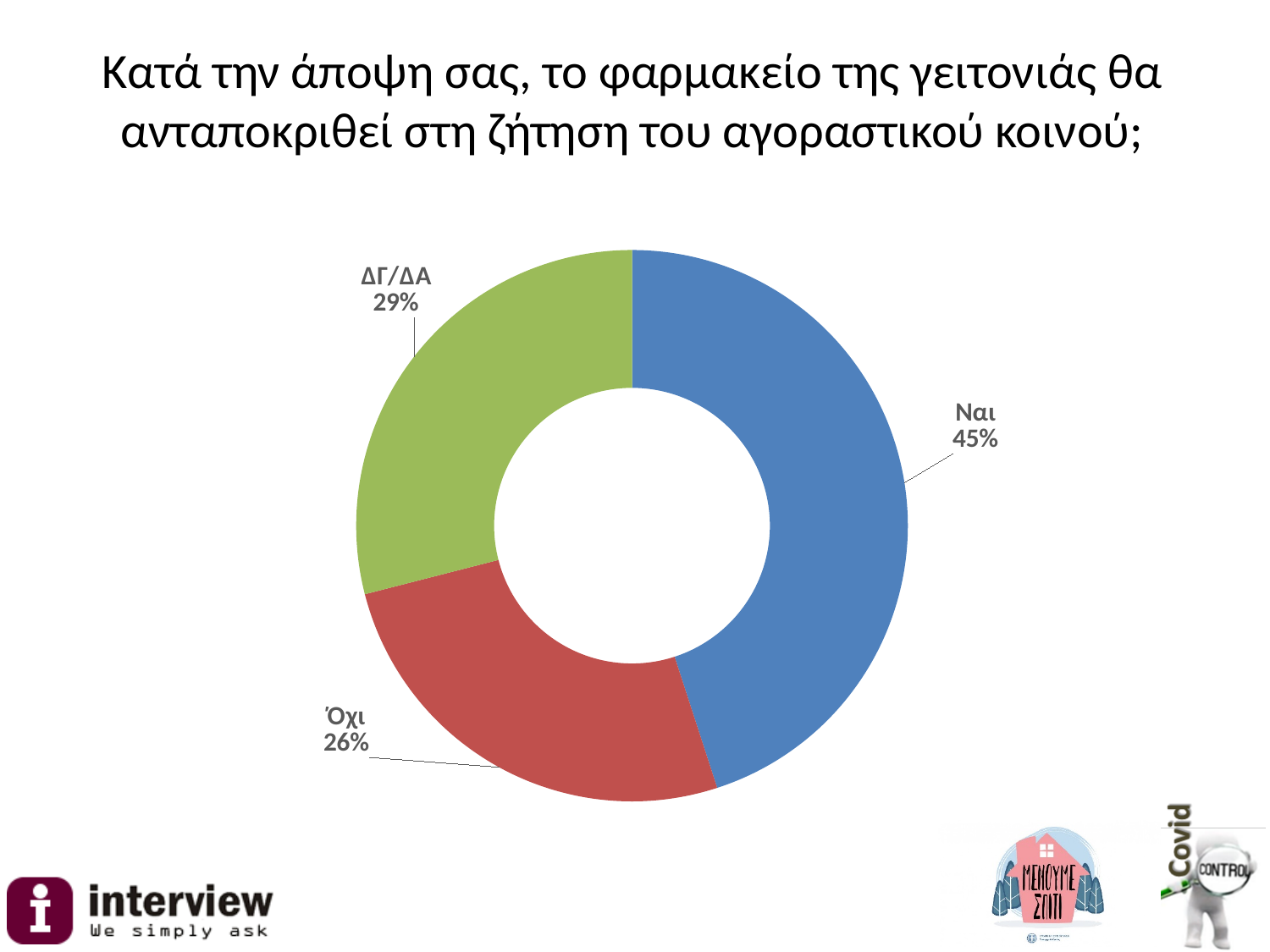
What percentage of respondents answered Όχι? 26% How many slices does the chart have? 3 What is the difference in percentage points between Ναι and Όχι? 19 Which response has the largest share of the chart? Ναι Which is larger, the share for Ναι or the share for ΔΓ/ΔΑ? Ναι Which response has the smallest share of the chart? Όχι What percentage of respondents answered Ναι? 45% What colour is the slice for Όχι? Red What is the difference in percentage points between ΔΓ/ΔΑ and Όχι? 3 What percentage of respondents answered ΔΓ/ΔΑ? 29% What kind of chart is shown on the slide? Doughnut (pie) chart What colour is the slice for Ναι? Blue